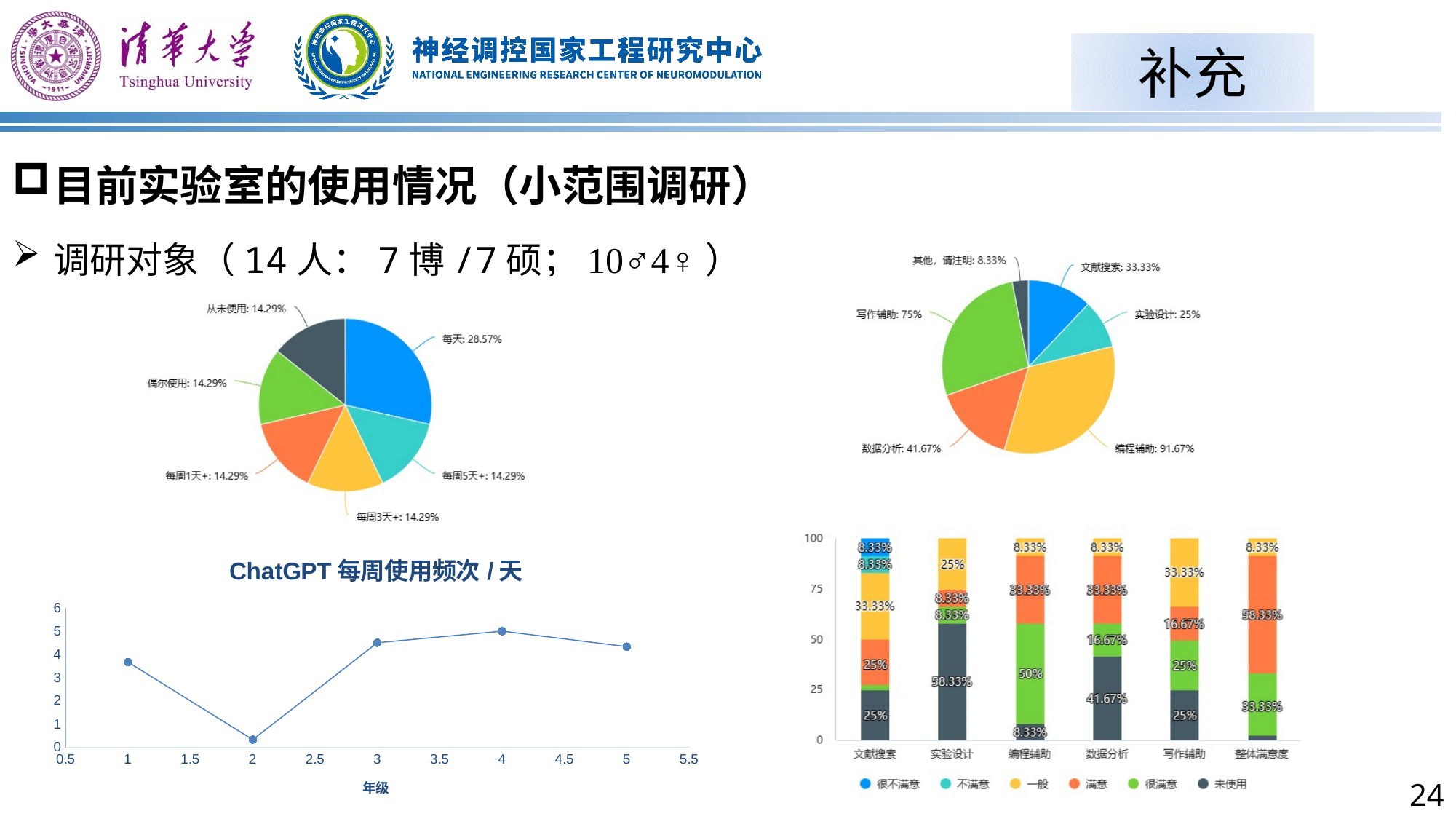
In the top-right pie chart, which category has the smallest labelled value? 其他, 请注明 In the bottom-left line chart, is the value at 年级 3 greater or less than 4? greater In the top-right pie chart, what is the difference between the values for 数据分析 and 实验设计? 16.67% In the bottom-left line chart, at which 年级 is the value lowest? 2 In the top-right pie chart, what value is labelled for 写作辅助? 75% In the top-right pie chart, what value is labelled for 编程辅助? 91.67% How many series does the legend of the bottom-right stacked bar chart list? 6 In the top-left pie chart, what share is labelled for 每天? 28.57% What type of chart is the bottom-left chart titled ChatGPT 每周使用频次 / 天? line chart How many slices does the top-left pie chart have? 6 In the top-left pie chart, which category has the largest slice? 每天 In the bottom-right stacked bar chart, what is the 未使用 value for 实验设计? 58.33%